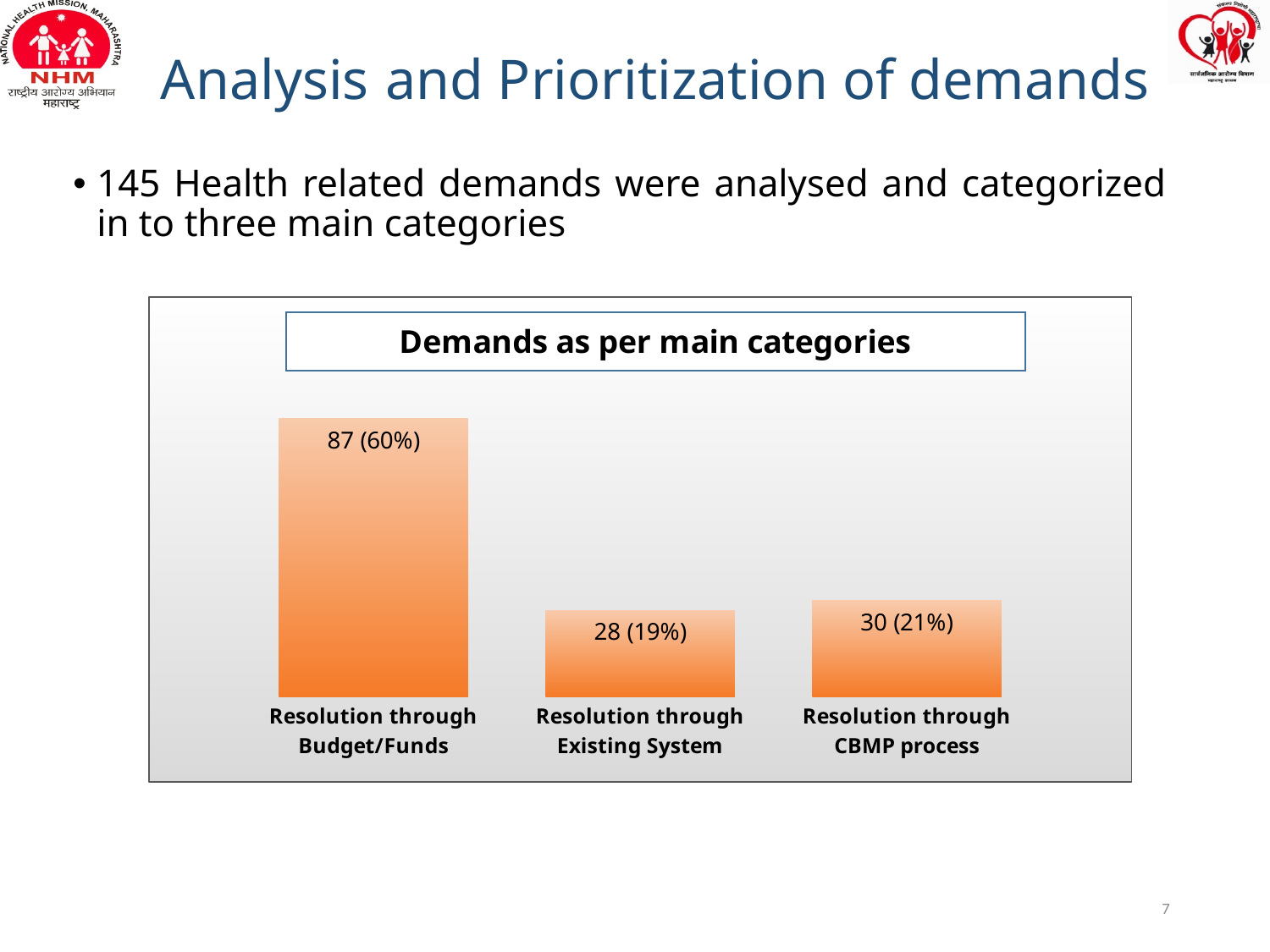
What is the title of the chart? Demands as per main categories What is the value shown for Resolution through CBMP process? 30 (21%) What is the difference in demands between Resolution through CBMP process and Resolution through Existing System? 2 Which category has the lowest number of demands? Resolution through Existing System What is the value shown for Resolution through Budget/Funds? 87 (60%) What type of chart is shown on the slide? Bar chart What is the difference in demands between Resolution through Budget/Funds and Resolution through CBMP process? 57 Which category has the highest number of demands? Resolution through Budget/Funds What is the total number of demands across the three categories in the chart? 145 What is the value shown for Resolution through Existing System? 28 (19%) How many categories are shown in the chart? 3 Which has more demands, Resolution through Existing System or Resolution through Budget/Funds? Resolution through Budget/Funds